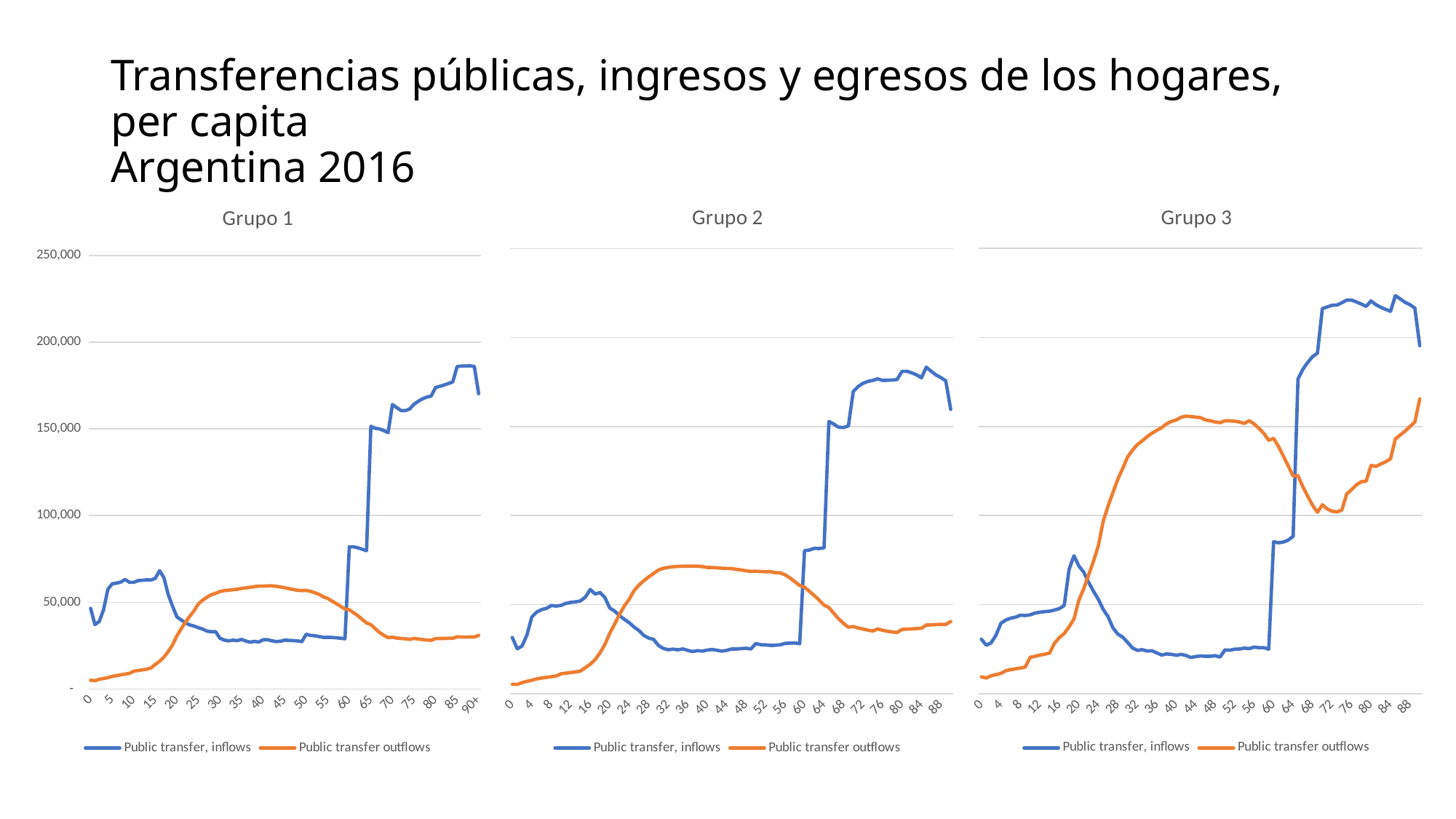
In the Grupo 1 chart, at age 80, which series is larger: Public transfer, inflows or Public transfer outflows? Public transfer, inflows What kind of chart is the Grupo 1 chart? line chart In the Grupo 3 chart, is the value for Public transfer, inflows at age 80 greater or less than 200,000? greater Which of the three charts shows the highest peak value for Public transfer, inflows? Grupo 3 In the Grupo 3 chart, do the values for Public transfer outflows rise or fall between age 20 and age 40? rise In the Grupo 1 chart, is the value for Public transfer, inflows at age 80 greater or less than 150,000? greater In the Grupo 3 chart, at age 40, which series is larger: Public transfer, inflows or Public transfer outflows? Public transfer outflows Which colour is used for the Public transfer outflows series in the charts? orange In the Grupo 3 chart, is the value for Public transfer outflows at age 44 greater or less than 100,000? greater How many series does the legend of the Grupo 2 chart list? 2